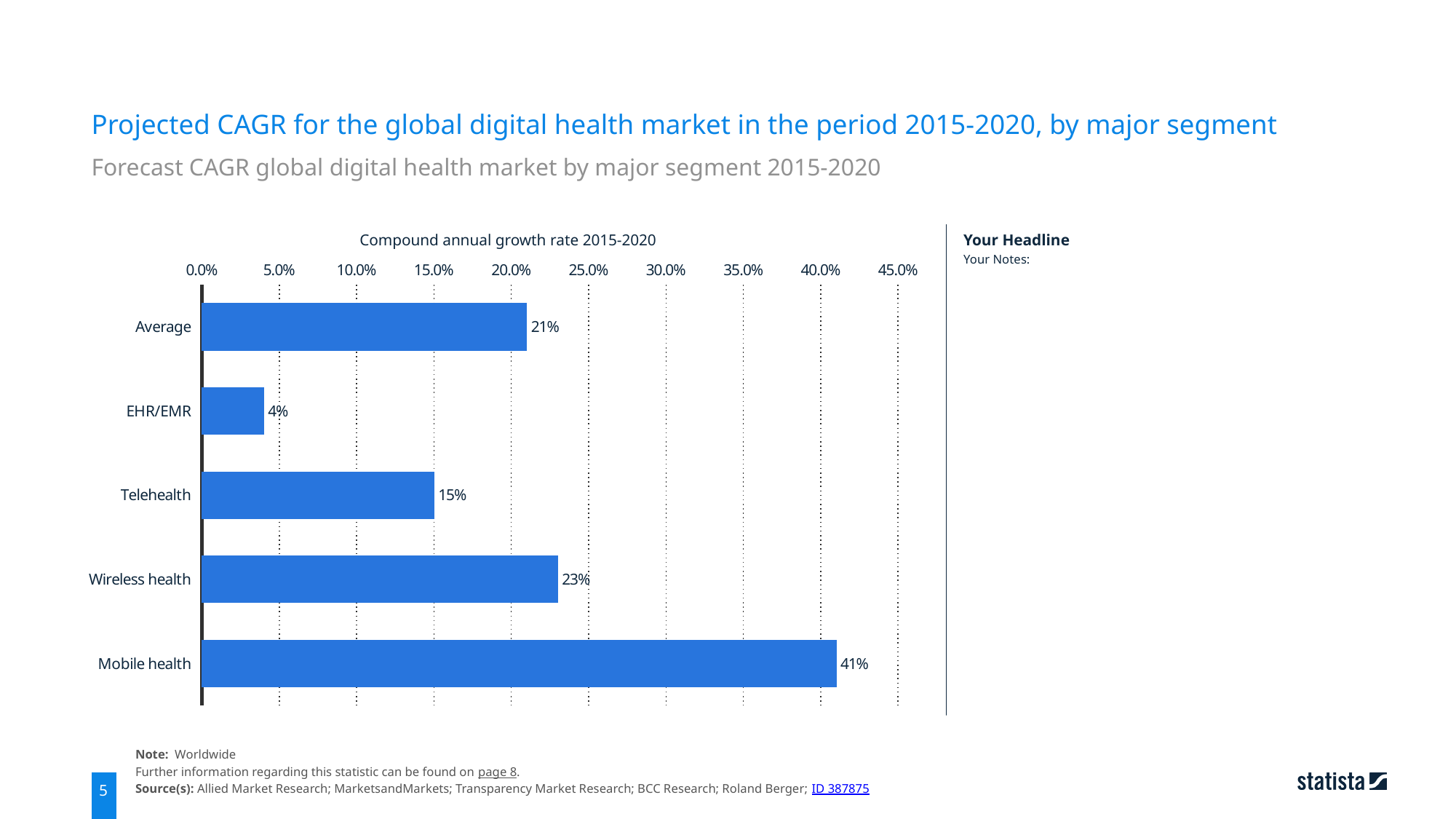
What is the projected CAGR for EHR/EMR? 4% Which has a higher projected CAGR, Wireless health or Average? Wireless health Which segment has the lowest projected CAGR? EHR/EMR Is the value for Telehealth greater or less than 20.0%? less What is the projected CAGR for Telehealth? 15% What is the projected CAGR for Mobile health? 41% What kind of chart is shown on the slide? Bar chart What is the projected CAGR for Wireless health? 23% What is the difference between the CAGR for Mobile health and the CAGR for Wireless health? 18% What is the title shown above the chart's axis? Compound annual growth rate 2015-2020 Which segment has the highest projected CAGR? Mobile health How many categories are shown on the chart? 5